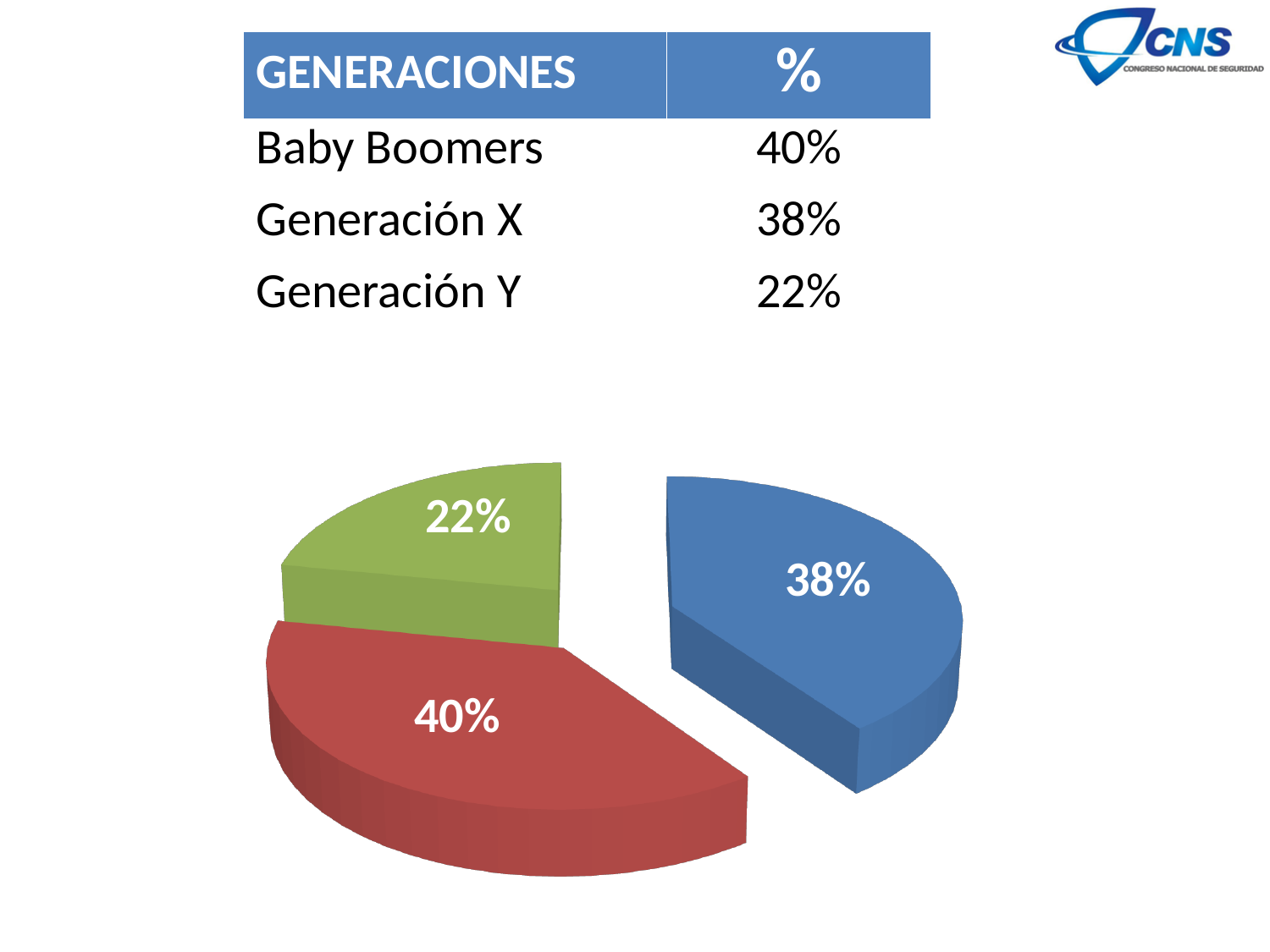
According to the table above the chart, what percentage corresponds to Generación Y? 22% Which slice of the pie chart is pulled out (exploded) from the rest? the blue 38% slice How many slices does the pie chart have? 3 What kind of chart is shown on the slide? pie chart What is the largest value shown on the pie chart? 40% What is the difference between the red slice value and the blue slice value? 2 percentage points What share of the pie does the blue slice represent? 38% Which slice is larger, the blue slice or the green slice? the blue slice What is the smallest value shown on the pie chart? 22% What is the value labelled on the red slice of the pie chart? 40% What is the difference between the largest and smallest slice values on the pie chart? 18 percentage points What is the value labelled on the green slice of the pie chart? 22%